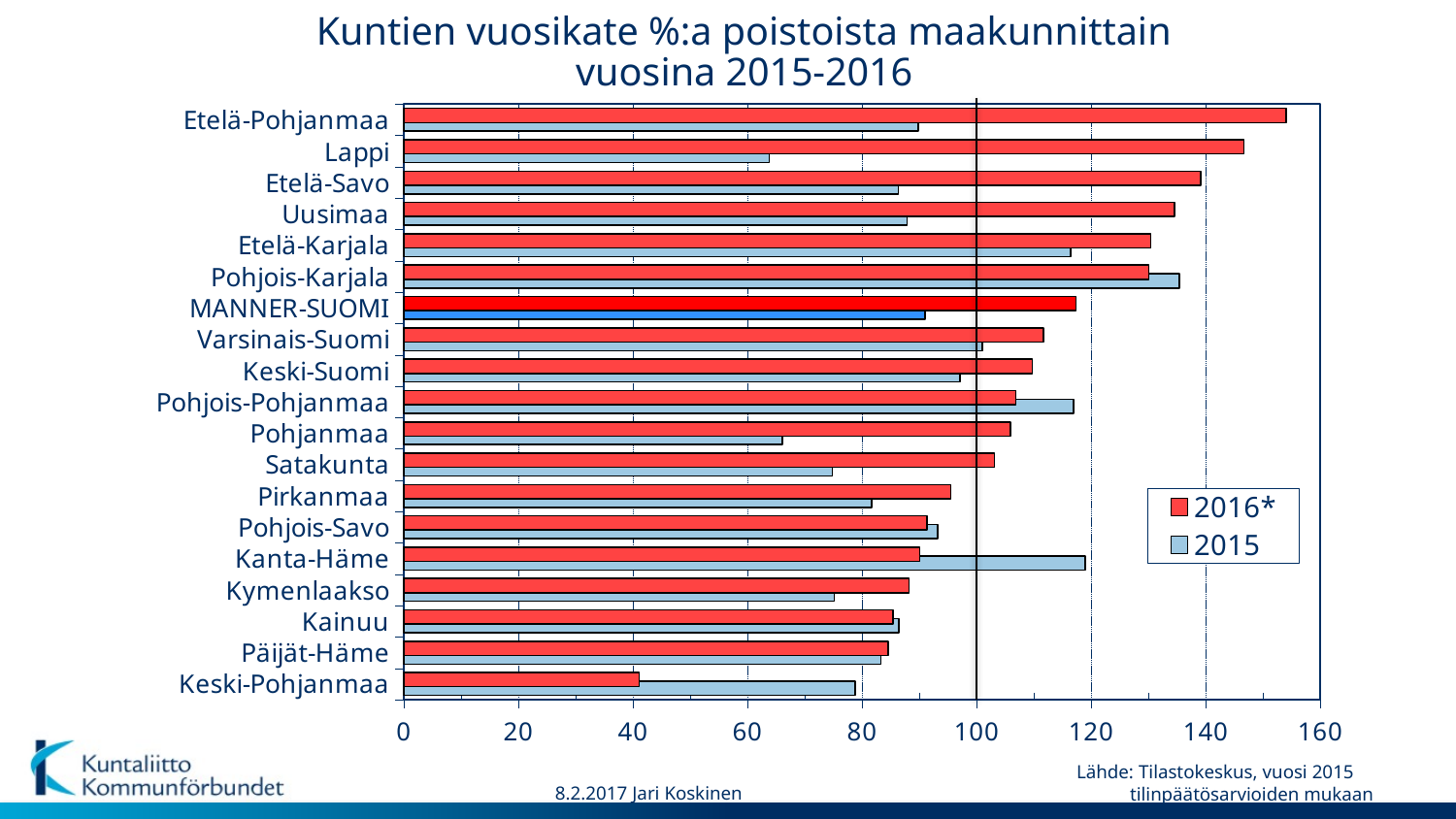
Which region has the lowest value for 2016*? Keski-Pohjanmaa What kind of chart is shown on the slide? bar chart For Kanta-Häme, which series has the larger value, 2016* or 2015? 2015 Which region has the highest value for 2016*? Etelä-Pohjanmaa Is the 2016* value for Etelä-Pohjanmaa greater or less than 140? greater How many series does the legend list? 2 Which region has the highest value for 2015? Pohjois-Karjala Which colour represents the 2016* series in the legend? red Is the 2015 value for Kanta-Häme greater or less than 100? greater How many regions (categories) are plotted on the chart? 19 Is the 2016* value for Keski-Pohjanmaa greater or less than 60? less